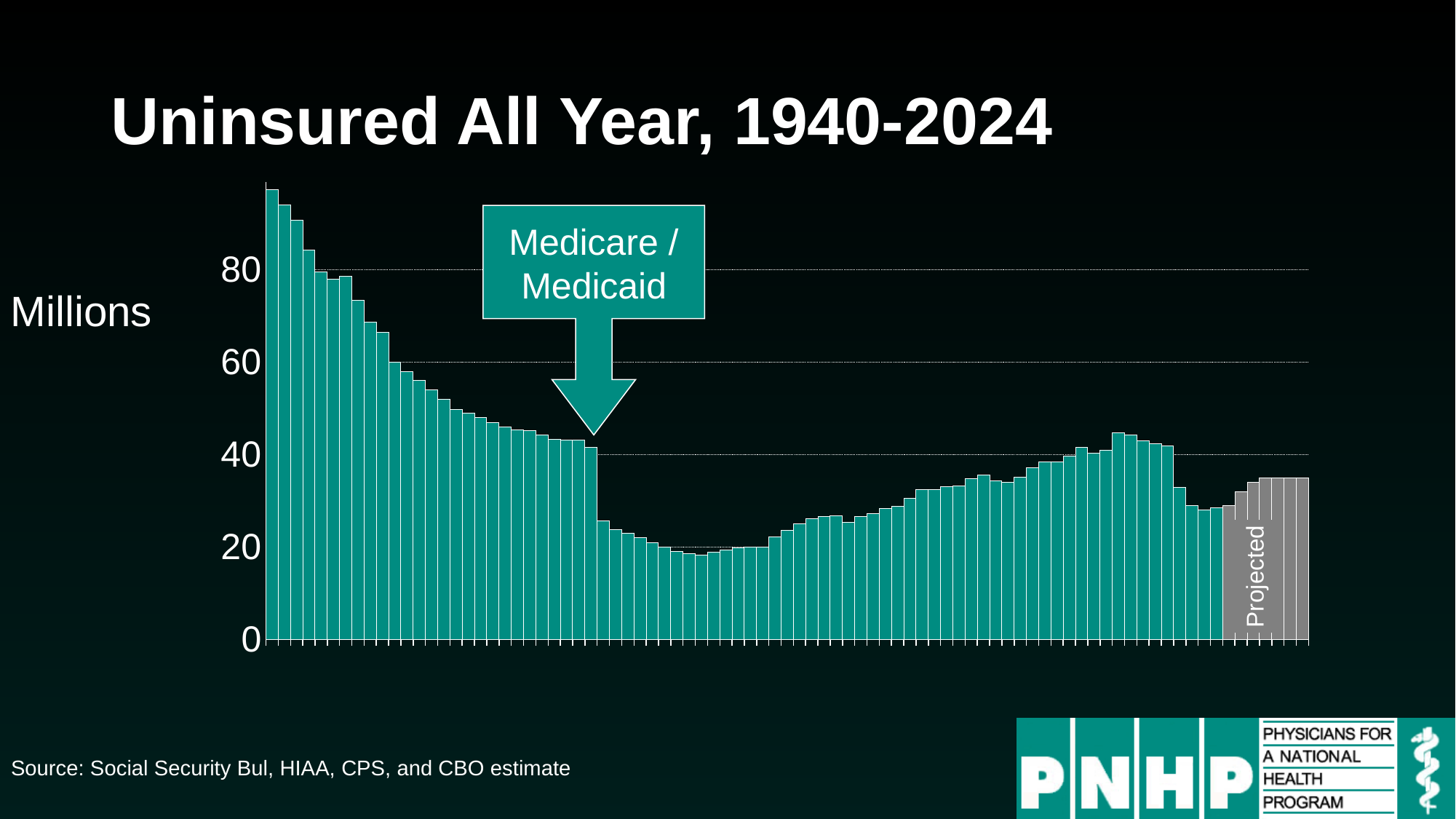
Is the value of the bar just before the Medicare / Medicaid arrow greater or less than 40? greater Is the value of the leftmost bar greater or less than 80? greater Is the value of the first bar immediately after the Medicare / Medicaid arrow greater or less than 40? less What is the title of the chart? Uninsured All Year, 1940-2024 Which bar has the highest value in the chart? the leftmost bar From the leftmost bar up to the Medicare / Medicaid arrow, do the values rise or fall? fall Which is larger, the leftmost bar or the rightmost bar? the leftmost bar What kind of chart is shown on the slide? bar chart What event does the arrow annotation on the chart mark? Medicare / Medicaid